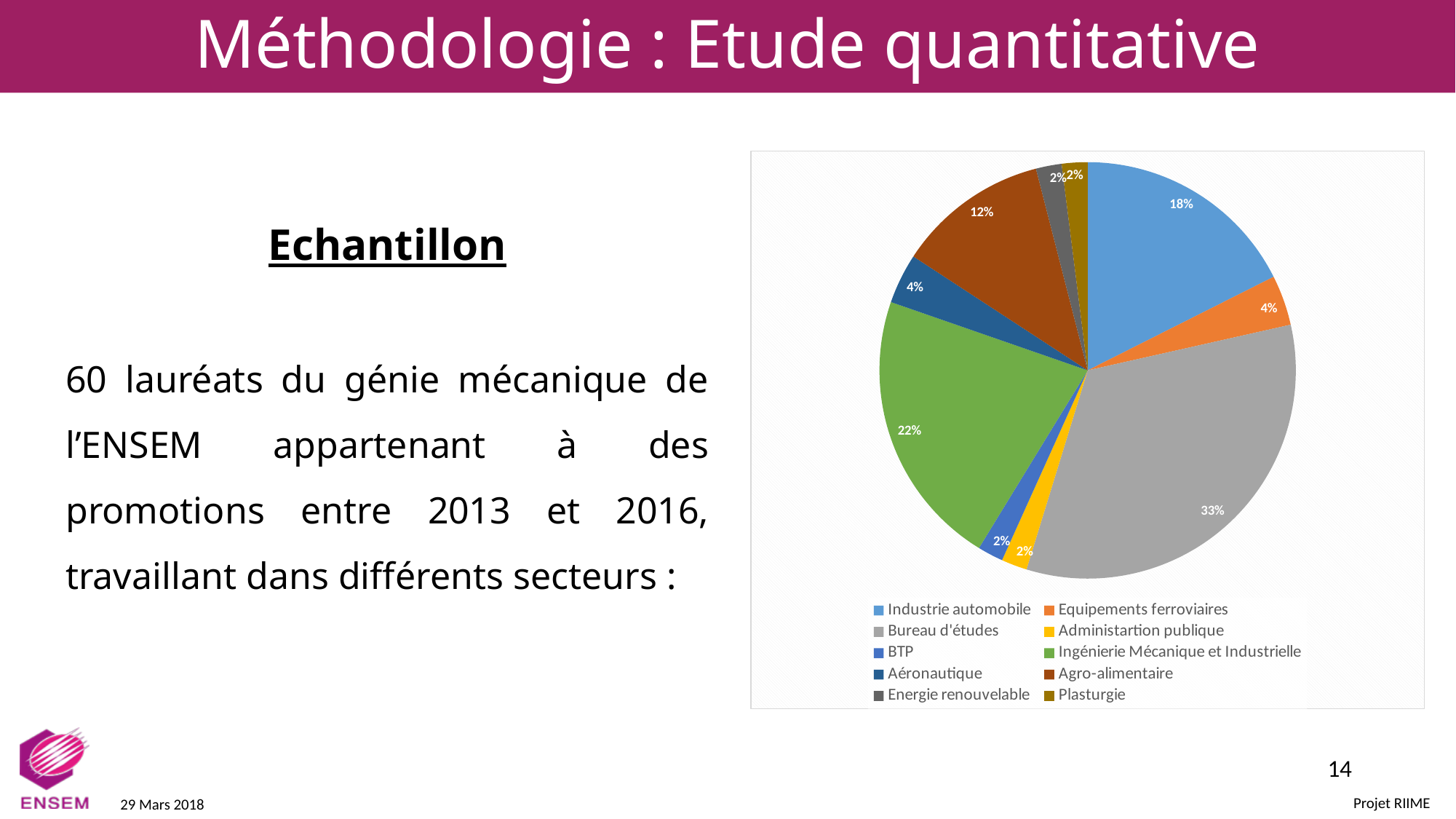
What is the difference in percentage points between Bureau d'études and Ingénierie Mécanique et Industrielle? 11 How many sectors are listed in the legend of the pie chart? 10 What is the difference in percentage points between Industrie automobile and Equipements ferroviaires? 14 What share of the pie does Bureau d'études represent? 33% What share of the pie does Industrie automobile represent? 18% Which is larger, the share for Industrie automobile or the share for Agro-alimentaire? Industrie automobile What kind of chart is shown on the slide? pie chart What share of the pie does Agro-alimentaire represent? 12% What share of the pie does Aéronautique represent? 4% What colour is the slice for Ingénierie Mécanique et Industrielle? green Which sector has the largest slice of the pie? Bureau d'études What share of the pie does Ingénierie Mécanique et Industrielle represent? 22%